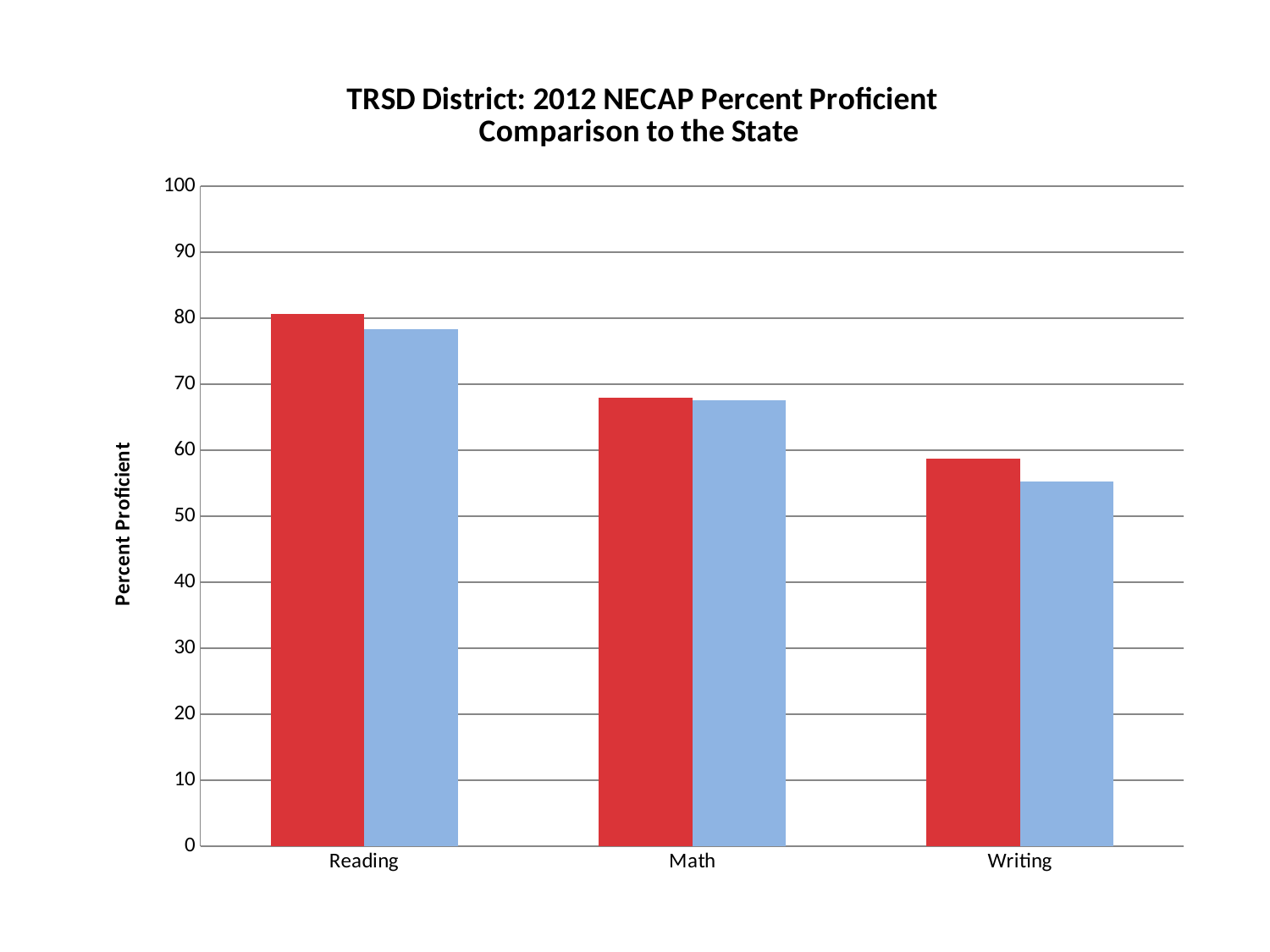
Which subject has the lowest blue bar? Writing For Writing, which bar is taller, the red bar or the blue bar? red bar Which subject has the highest red bar? Reading Is the blue bar for Writing greater or less than 60? less Is the red bar for Math greater or less than 70? less What kind of chart is shown on the slide? bar chart How many bars are shown for each subject category? 2 Do the red bars rise or fall moving from Reading to Writing along the x axis? fall For Reading, which bar is taller, the red bar or the blue bar? red bar How many subject categories are shown on the x axis? 3 What is the label on the vertical axis? Percent Proficient